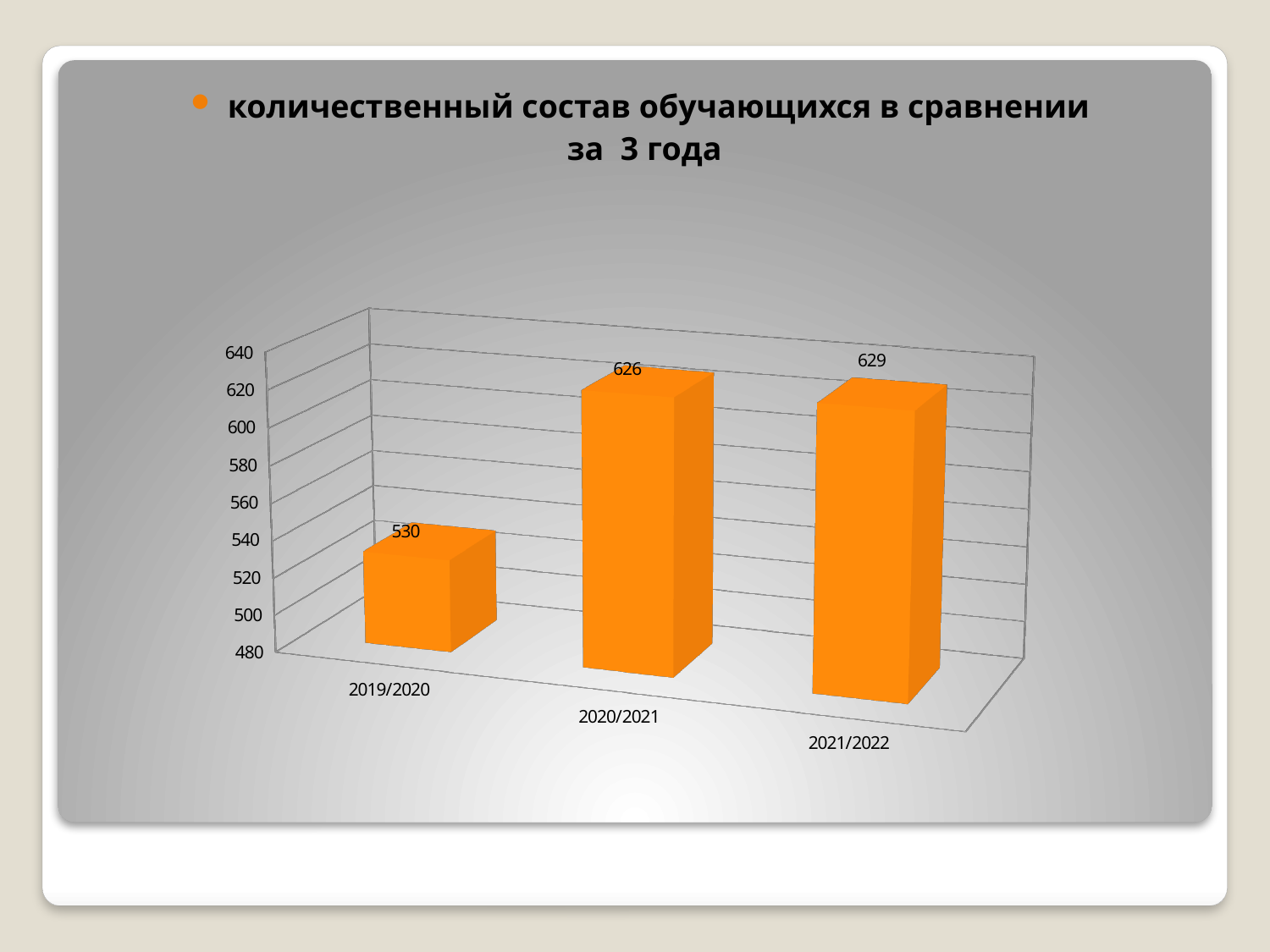
Which year has the highest value? 2021/2022 What is the difference between the values for 2020/2021 and 2019/2020? 96 What is the value for 2020/2021? 626 Is the value for 2019/2020 greater or less than 600? less Which is larger, the value for 2019/2020 or the value for 2020/2021? 2020/2021 What is the value for 2019/2020? 530 What is the value for 2021/2022? 629 What is the difference between the values for 2021/2022 and 2020/2021? 3 What kind of chart is shown on the slide? bar chart Do the values rise or fall from 2019/2020 to 2021/2022? rise Which year has the lowest value? 2019/2020 How many categories are shown on the x axis? 3